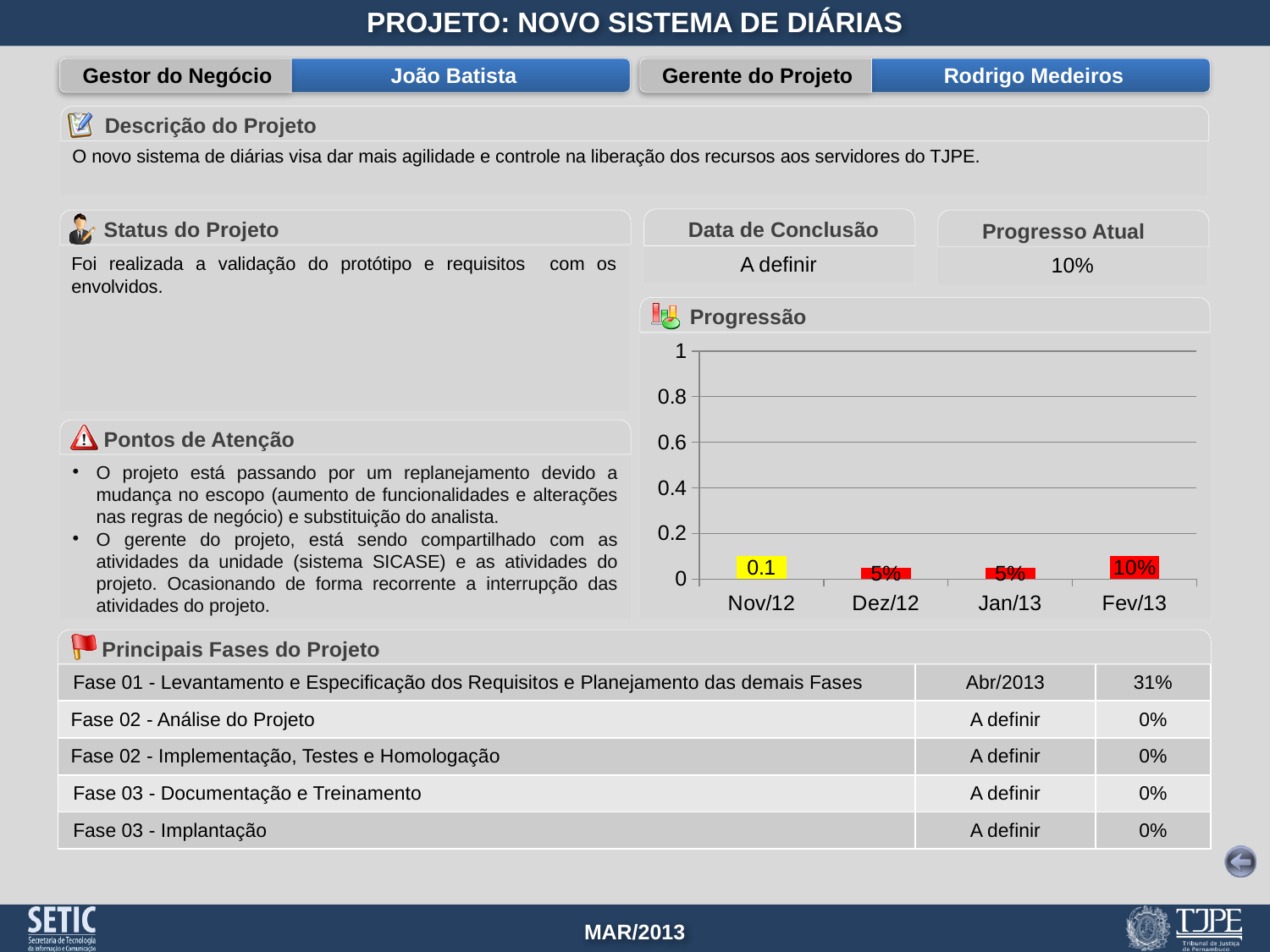
How many categories are shown on the x axis of the Progressão chart? 4 What kind of chart is the Progressão chart? bar chart In the Progressão chart, is the value for Fev/13 greater or less than 0.2? less In the Progressão chart, does the value rise or fall from Jan/13 to Fev/13? rise In the Progressão chart, what colour is the bar for Nov/12? yellow What is the title of the chart on the slide? Progressão In the Progressão chart, what is the value for Fev/13? 10% In the Progressão chart, what is the value for Dez/12? 5% In the Progressão chart, what is the value for Nov/12? 0.1 In the Progressão chart, which is larger, the value for Nov/12 or the value for Dez/12? Nov/12 In the Progressão chart, what is the difference between the values for Fev/13 and Jan/13? 5% In the Progressão chart, what is the value for Jan/13? 5%